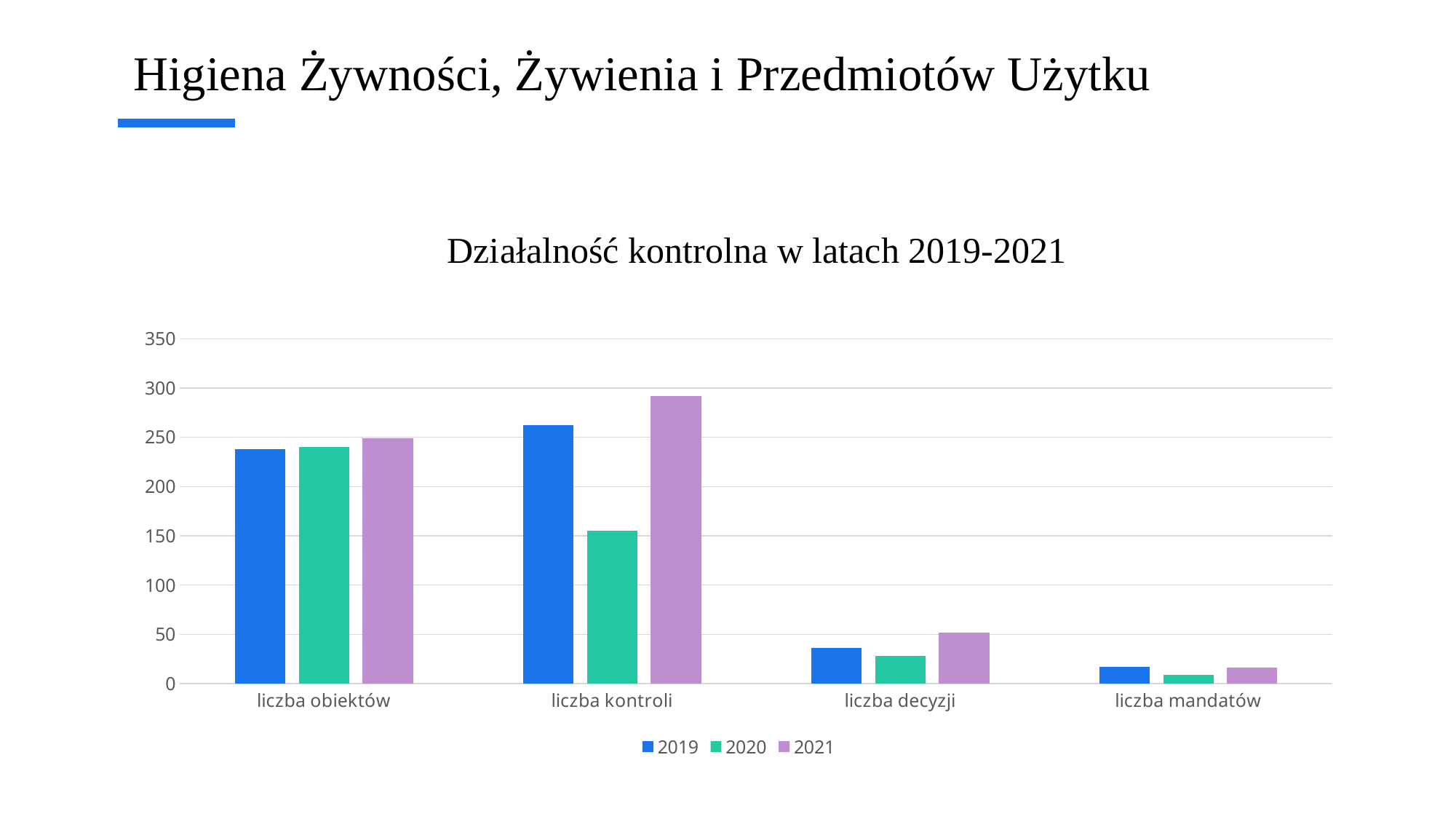
What is the title of the chart? Działalność kontrolna w latach 2019-2021 Which year has the highest bar for liczba kontroli? 2021 Is the 2020 value for liczba kontroli greater or less than 200? less How many categories are shown on the x axis? 4 What kind of chart is shown on the slide? bar chart Which year has the lowest bar for liczba kontroli? 2020 Is the 2021 value for liczba decyzji greater or less than 100? less For liczba kontroli, which is larger: the 2019 value or the 2020 value? 2019 How many series does the legend list? 3 Which category has the highest 2021 bar? liczba kontroli Is the 2021 value for liczba kontroli greater or less than 250? greater Which category has the lowest bars overall? liczba mandatów